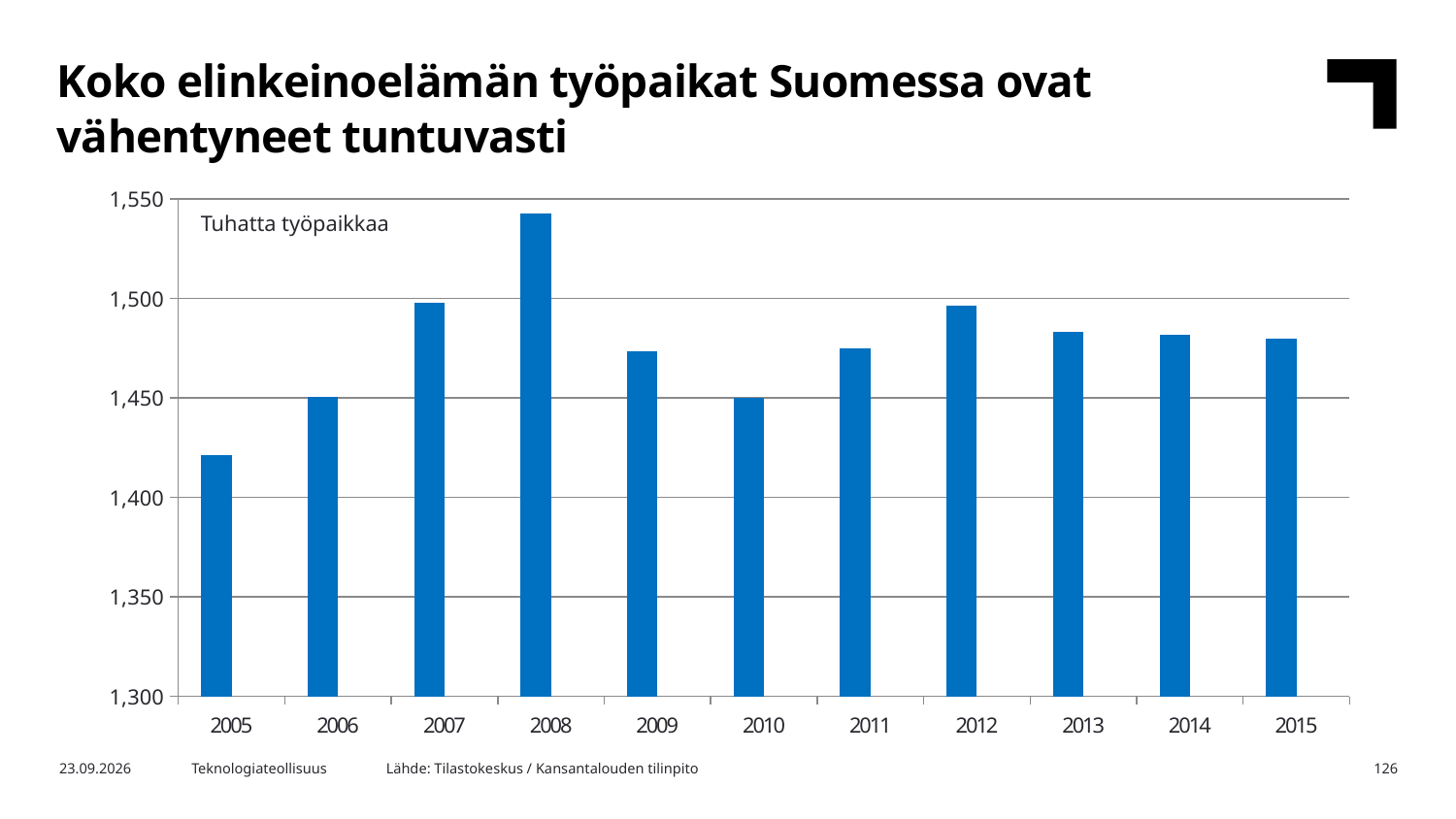
Is the value for 2005 greater or less than 1,450? less Which year has the larger value, 2007 or 2009? 2007 What unit label is printed inside the chart area? Tuhatta työpaikkaa Is the value for 2008 greater or less than 1,500? greater Which year has the highest number of jobs in the chart? 2008 Do the values rise or fall from 2005 to 2008? rise Which year has the lowest number of jobs in the chart? 2005 What kind of chart is shown on the slide? bar chart Is the value for 2009 greater or less than 1,450? greater How many years are shown on the x axis of the chart? 11 Which year has the larger value, 2005 or 2010? 2010